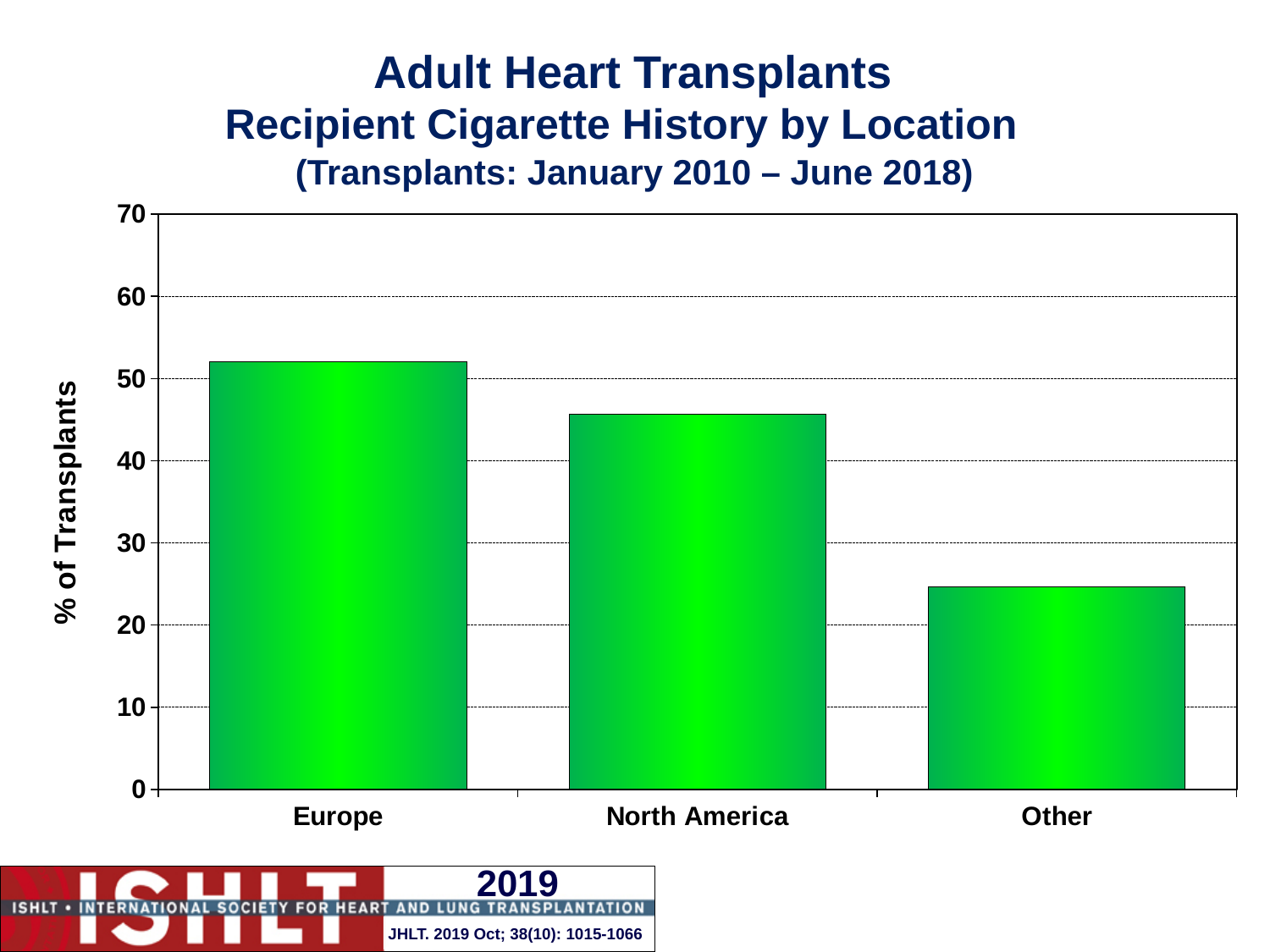
Which location has the highest percentage of transplants with a recipient cigarette history? Europe Is the value for North America greater or less than 50? less How many location categories are plotted on the chart? 3 What kind of chart is shown on the slide? bar chart What is the label of the y axis? % of Transplants Which is larger, the value for North America or the value for Other? North America Is the value for Europe greater or less than 50? greater Do the bar values rise or fall from left to right across the x axis? fall Which location has the lowest percentage of transplants with a recipient cigarette history? Other What transplant date range is given in the chart title? January 2010 – June 2018 Is the value for Other greater or less than 30? less